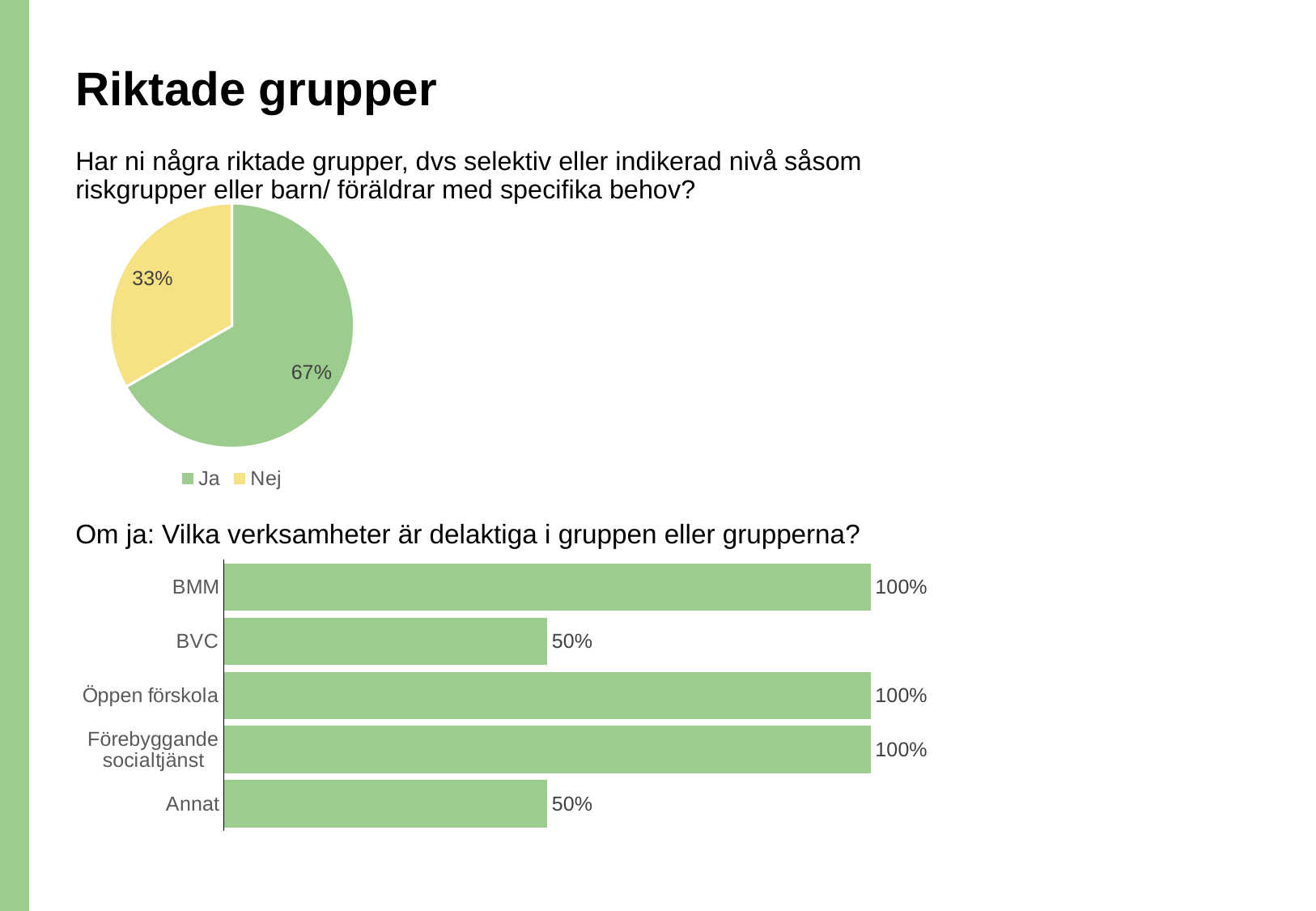
In the bar chart at the bottom of the slide, what is the value for Annat? 50% What kind of chart is the chart at the bottom of the slide? Bar chart In the bar chart at the bottom of the slide, what is the value for Öppen förskola? 100% In the pie chart at the top of the slide, what share is labelled for "Nej"? 33% In the pie chart at the top of the slide, what share is labelled for "Ja"? 67% In the pie chart at the top of the slide, which slice is larger, "Ja" or "Nej"? Ja In the bar chart at the bottom of the slide, which is larger, the value for Förebyggande socialtjänst or the value for Annat? Förebyggande socialtjänst What kind of chart is the chart at the top of the slide? Pie chart In the bar chart at the bottom of the slide, how many categories are shown? 5 In the pie chart at the top of the slide, how many entries does the legend list? 2 In the bar chart at the bottom of the slide, what is the value for BVC? 50% In the bar chart at the bottom of the slide, what is the difference between the values for BMM and BVC? 50%